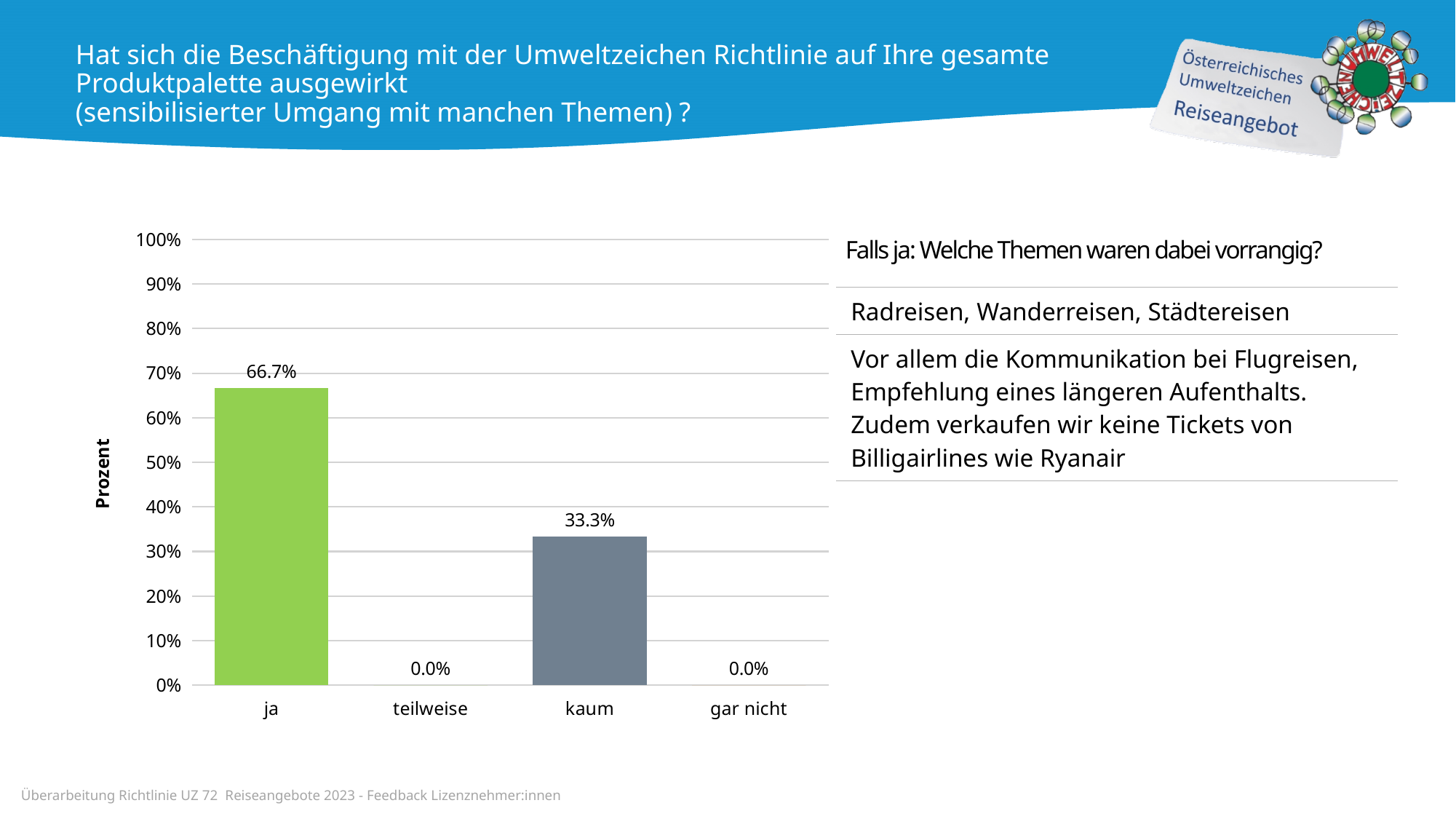
Is the value for "kaum" greater or less than 40%? less What is the value for "kaum"? 33.3% What is the value for "ja"? 66.7% What is the difference between the values for "ja" and "kaum"? 33.4% Which is larger, the value for "ja" or the value for "kaum"? ja What is the value for "teilweise"? 0.0% What is the label of the vertical axis? Prozent Is the value for "ja" greater or less than 60%? greater What is the value for "gar nicht"? 0.0% Which category has the highest value? ja What kind of chart is shown on the slide? bar chart How many categories are shown on the x axis? 4